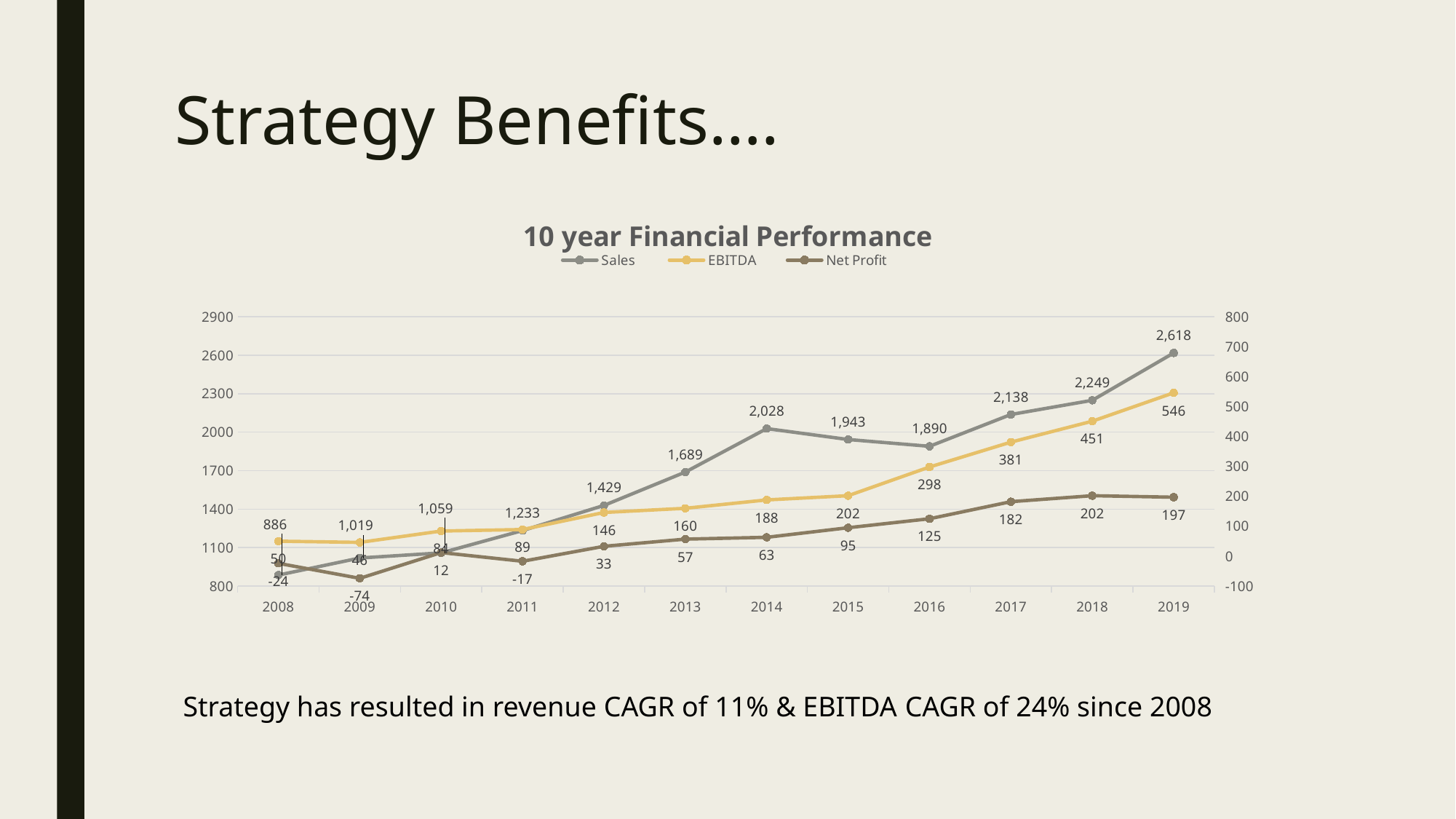
In which year is Sales highest? 2019 How many series does the legend list? 3 Does EBITDA generally rise or fall from 2008 to 2019? Rise Which year has higher Net Profit, 2018 or 2019? 2018 What is the Net Profit value for 2011? -17 Which year has higher Sales, 2014 or 2015? 2014 In which year is Net Profit lowest? 2009 What is the Sales value for 2019? 2,618 What kind of chart is shown? Line chart How many years are plotted on the x axis? 12 What is the difference between Sales in 2019 and Sales in 2018? 369 What is the EBITDA value for 2016? 298